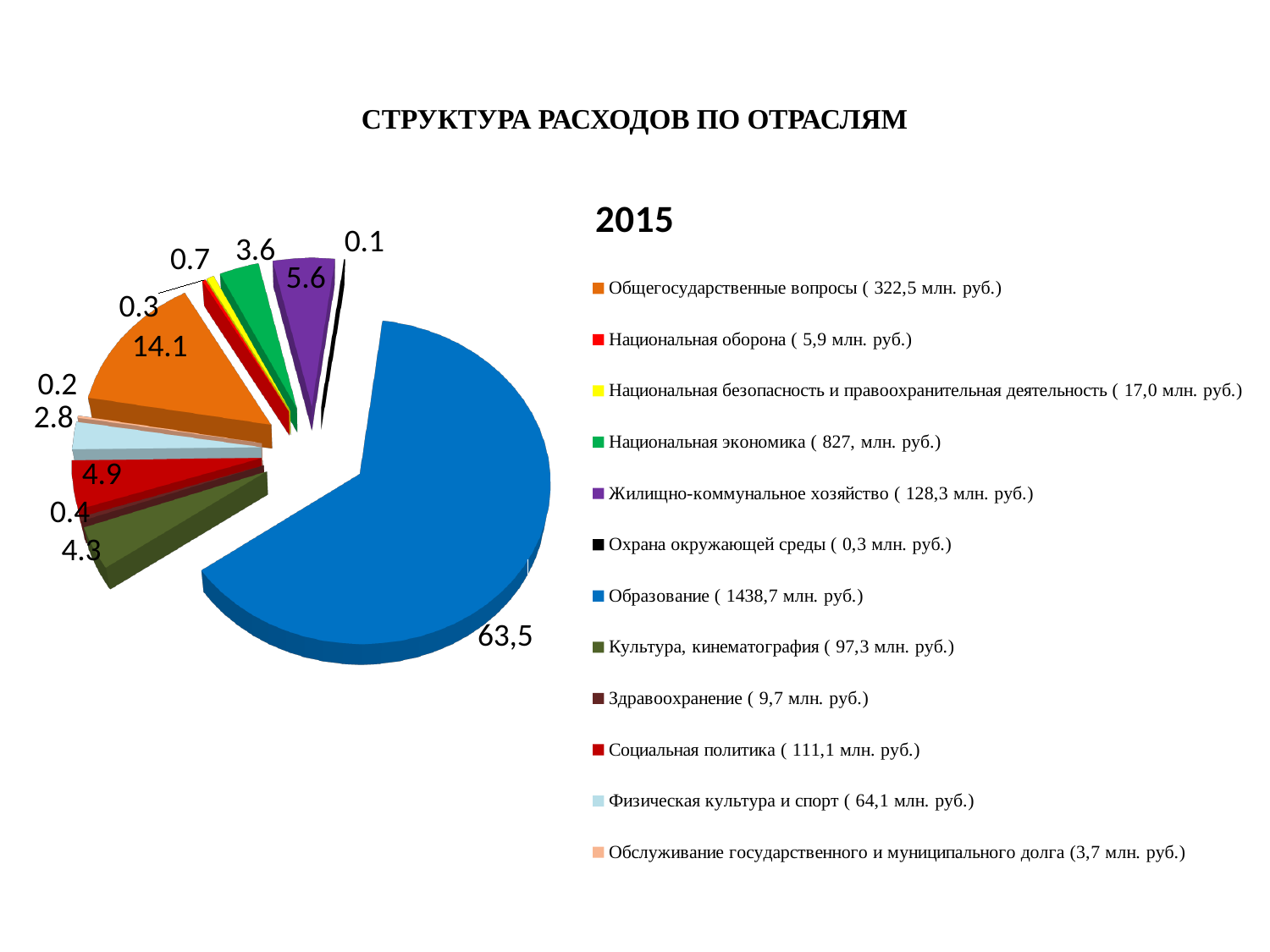
What is the data label for the Физическая культура и спорт slice? 2.8 What is the difference between the data labels for Общегосударственные вопросы and Жилищно-коммунальное хозяйство? 8.5 What kind of chart is shown on the slide? pie chart What is the data label for the Социальная политика slice? 4.9 Which slice is larger: Культура, кинематография or Национальная экономика? Культура, кинематография How many categories does the legend list? 12 Which category has the largest slice of the pie? Образование What is the data label for the Общегосударственные вопросы slice? 14.1 What is the data label for the Образование slice? 63,5 What is the data label for the Жилищно-коммунальное хозяйство slice? 5.6 What amount in млн. руб. does the legend give for Образование? 1438,7 млн. руб. Which category has the smallest slice of the pie? Охрана окружающей среды